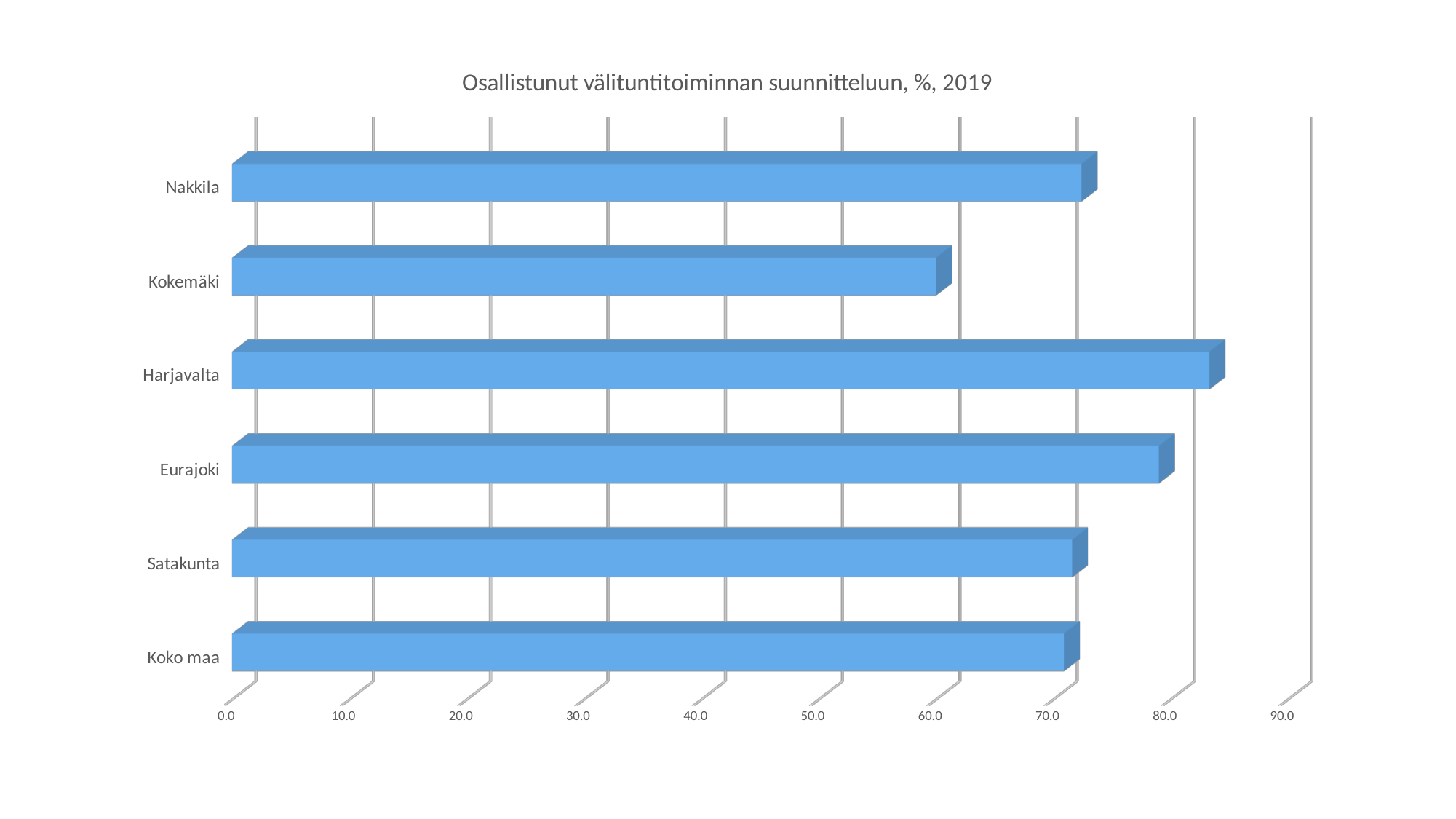
Which has a larger value, Harjavalta or Kokemäki? Harjavalta Which category has the highest value? Harjavalta Is the value for Nakkila greater or less than 80.0? less What kind of chart is shown on the slide? Bar chart How many categories are shown in the chart? 6 What is the title of the chart? Osallistunut välituntitoiminnan suunnitteluun, %, 2019 Is the value for Koko maa greater or less than 80.0? less Which category has the lowest value? Kokemäki Is the value for Kokemäki greater or less than 70.0? less Which has a larger value, Eurajoki or Koko maa? Eurajoki